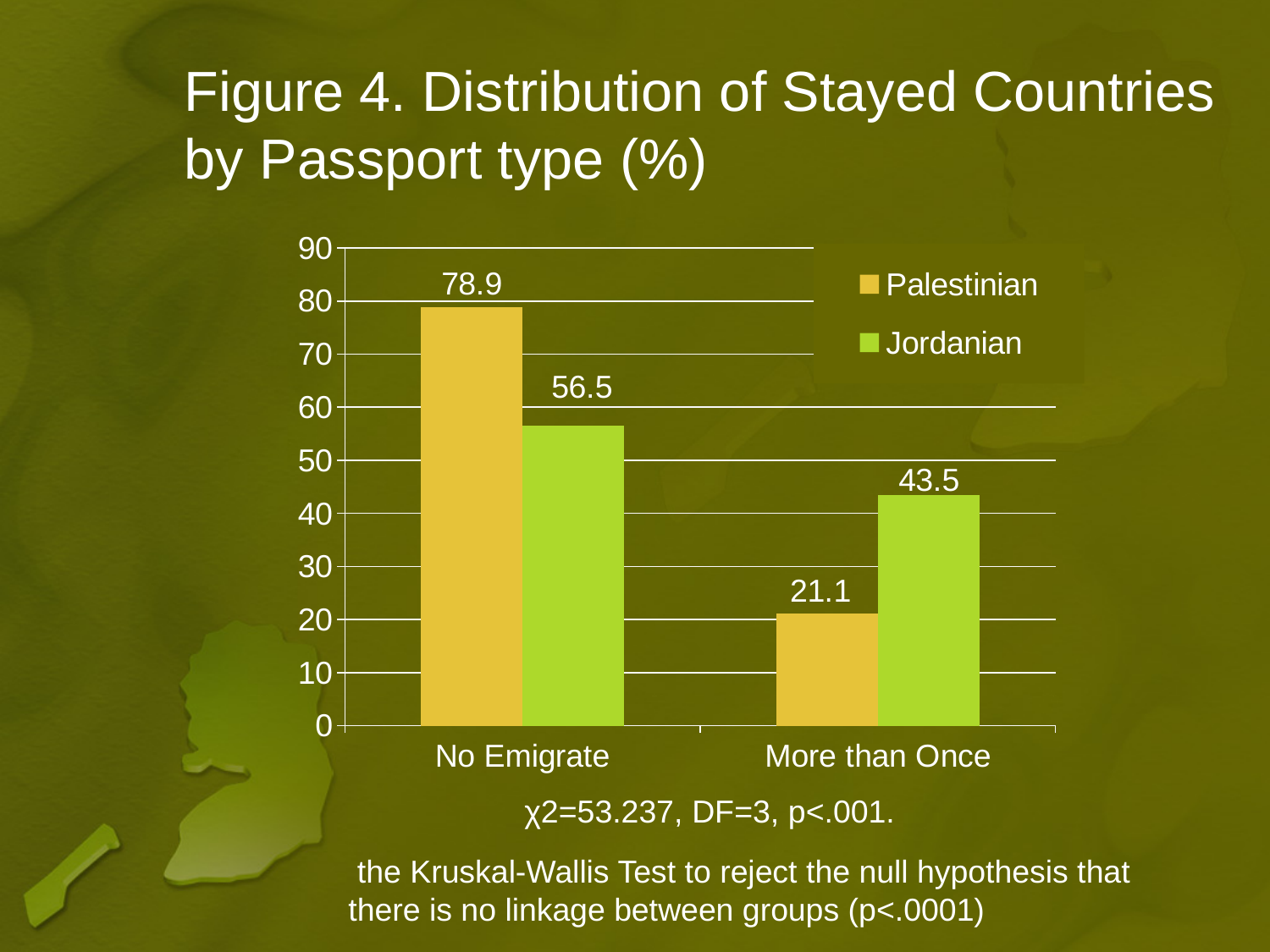
Which series has the highest value in the No Emigrate category? Palestinian Which is larger: the Jordanian value for No Emigrate or the Jordanian value for More than Once? No Emigrate What is the value for Jordanian in the No Emigrate category? 56.5 What is the difference between the Jordanian and Palestinian values in the More than Once category? 22.4 What is the value for Palestinian in the No Emigrate category? 78.9 What kind of chart is shown on the slide? Bar chart Which series has the lowest value in the More than Once category? Palestinian How many series does the legend list? 2 What is the difference between the Palestinian and Jordanian values in the No Emigrate category? 22.4 What is the value for Jordanian in the More than Once category? 43.5 What colour represents the Jordanian series in the chart? Green How many categories are shown on the x axis? 2